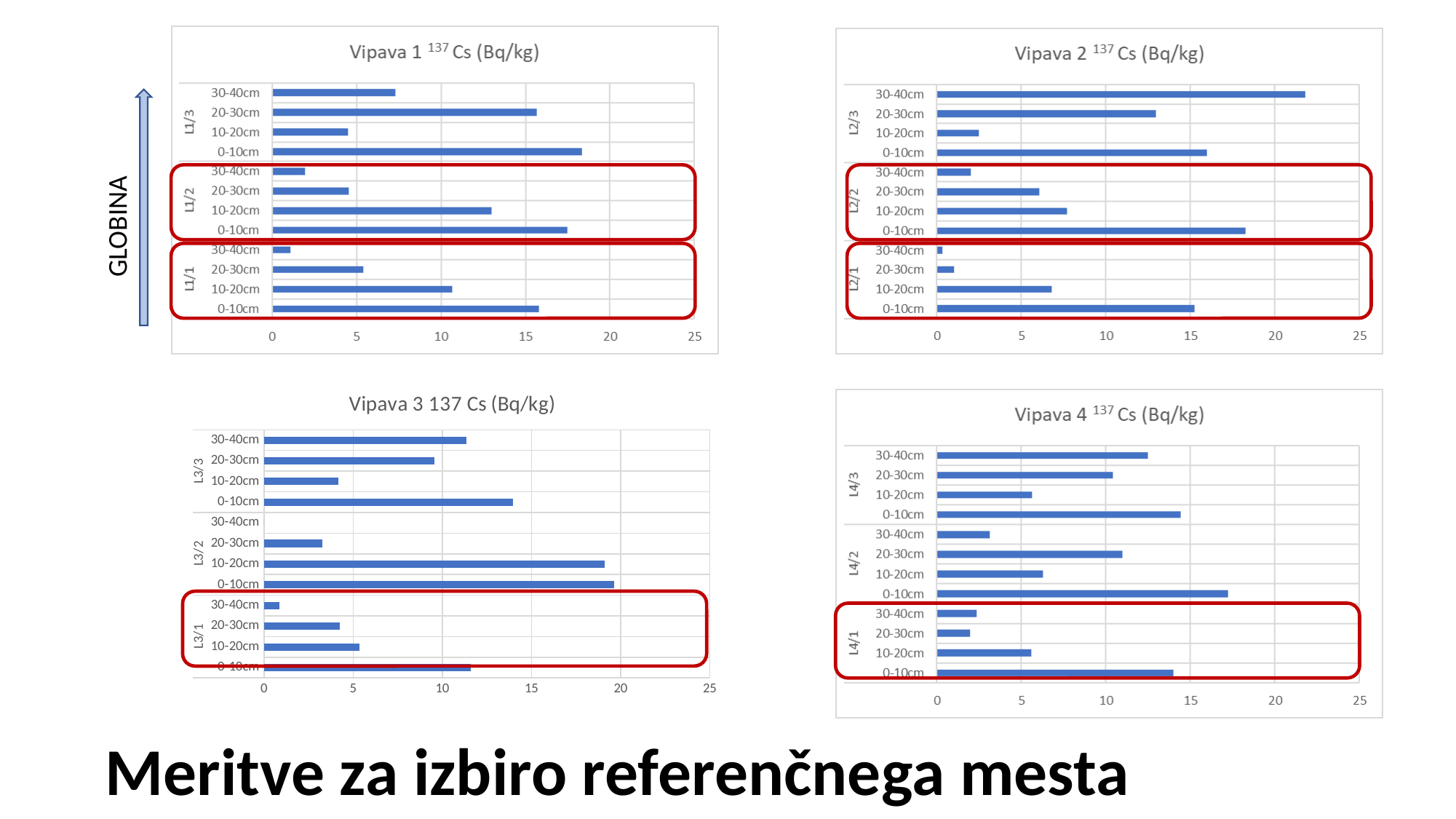
What kind of chart is the Vipava 1 137 Cs (Bq/kg) chart? bar chart In the Vipava 4 137 Cs (Bq/kg) chart, is the value for L4/2 0-10cm greater or less than 15? greater In the Vipava 3 137 Cs (Bq/kg) chart, is the value for L3/1 0-10cm greater or less than 10? greater In the Vipava 2 137 Cs (Bq/kg) chart, do the values for L2/1 rise or fall going from 0-10cm to 30-40cm? fall In the Vipava 2 137 Cs (Bq/kg) chart, which bar is the highest? L2/3 30-40cm In the Vipava 4 137 Cs (Bq/kg) chart, which is larger: the 30-40cm value for L4/3 or the 20-30cm value for L4/3? L4/3 30-40cm In the Vipava 3 137 Cs (Bq/kg) chart, which is larger: the 10-20cm value for L3/2 or the 10-20cm value for L3/3? L3/2 10-20cm In the Vipava 1 137 Cs (Bq/kg) chart, which bar is the lowest? L1/1 30-40cm In the Vipava 2 137 Cs (Bq/kg) chart, is the value for L2/3 30-40cm greater or less than 20? greater In the Vipava 2 137 Cs (Bq/kg) chart, which bar is the lowest? L2/1 30-40cm What is the highest tick value shown on the x axis of the Vipava 4 137 Cs (Bq/kg) chart? 25 How many bars are plotted in the Vipava 1 137 Cs (Bq/kg) chart? 12